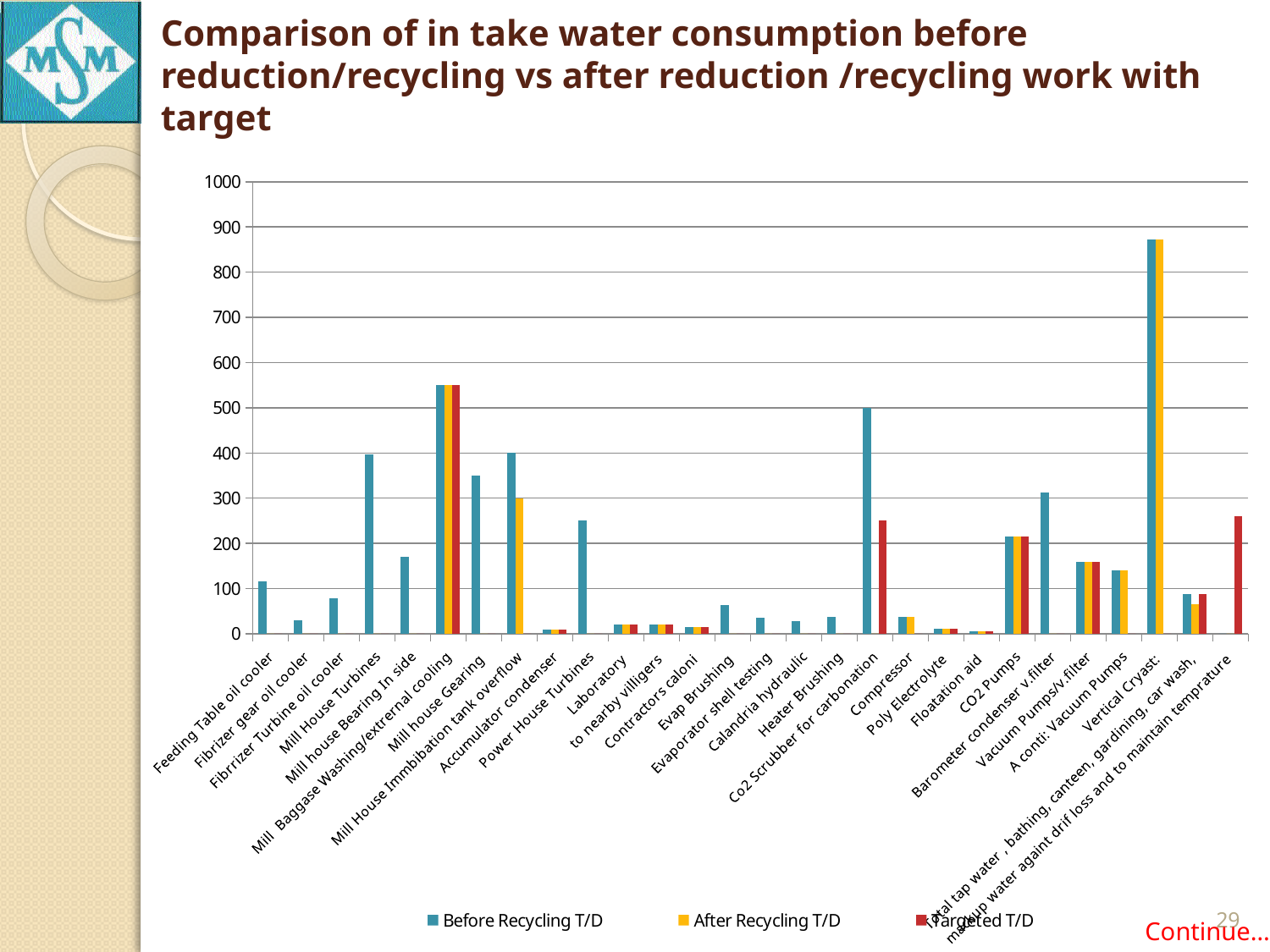
Which category has the highest Before Recycling T/D value? Vertical Cryast: What is the name of the series shown in red in the legend? Targeted T/D Is the Before Recycling T/D value for Feeding Table oil cooler greater or less than 100? greater Is the Before Recycling T/D value for Mill Baggase Washing/extrernal cooling greater or less than 500? greater Is the Before Recycling T/D value for Power House Turbines greater or less than 300? less Which is larger for Before Recycling T/D: Mill Baggase Washing/extrernal cooling or Co2 Scrubber for carbonation? Mill Baggase Washing/extrernal cooling Which is larger for Before Recycling T/D: Mill House Turbines or Mill house Gearing? Mill House Turbines How many series does the legend list? 3 What type of chart is shown on the slide? bar chart What is the highest value shown on the vertical axis? 1000